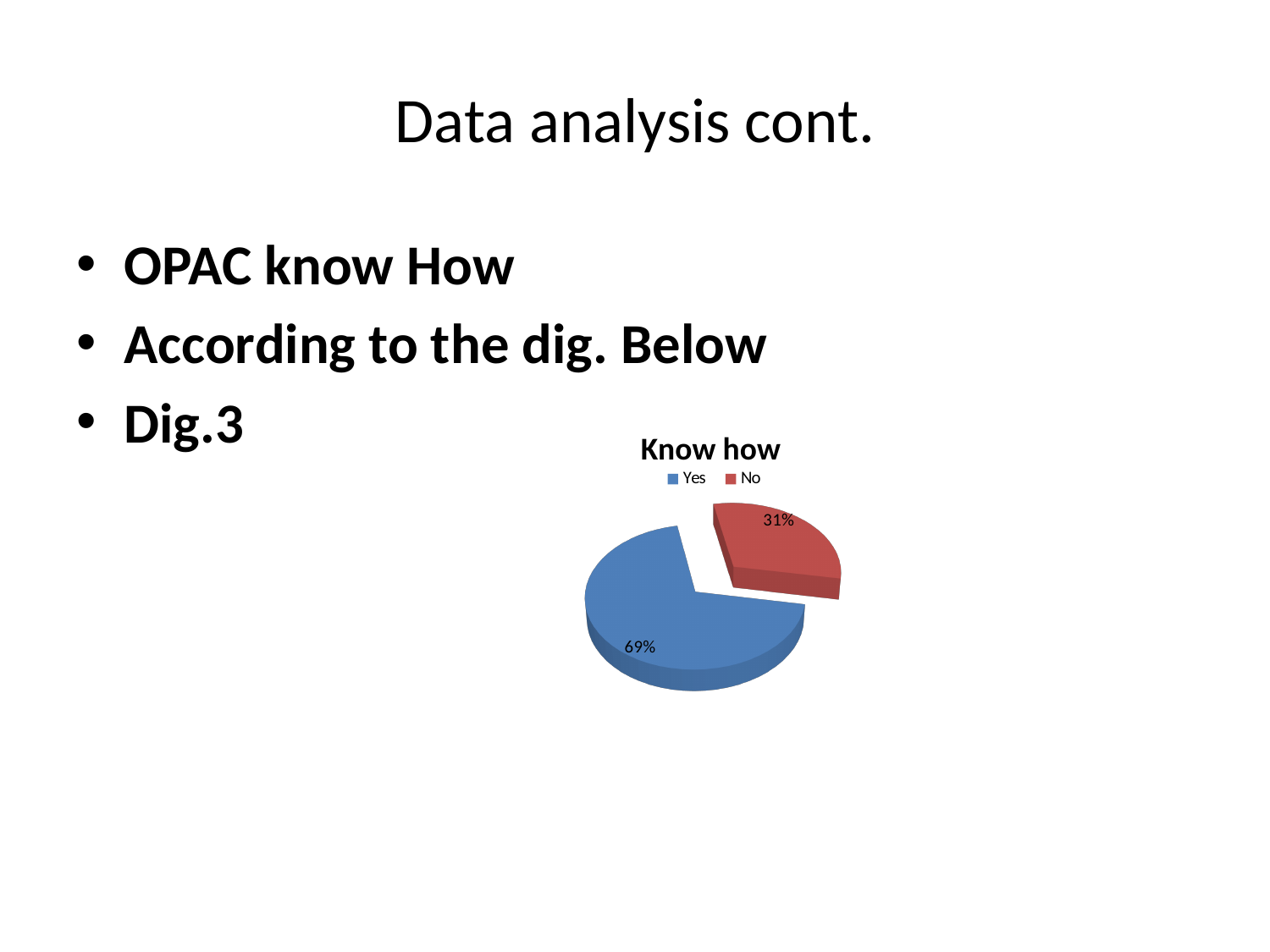
What colour is the Yes slice? blue Which slice is the largest in the pie chart? Yes How many slices does the pie chart have? 2 What is the difference in percentage points between the Yes and No slices? 38 Which slice is the smallest in the pie chart? No What share of the pie does the No slice represent? 31% What is the title of the chart? Know how What percentage of the pie is the Yes slice? 69% How many entries does the legend list? 2 What kind of chart is shown on the slide? pie chart What percentage of the pie is the No slice? 31% Which is larger, the Yes slice or the No slice? Yes